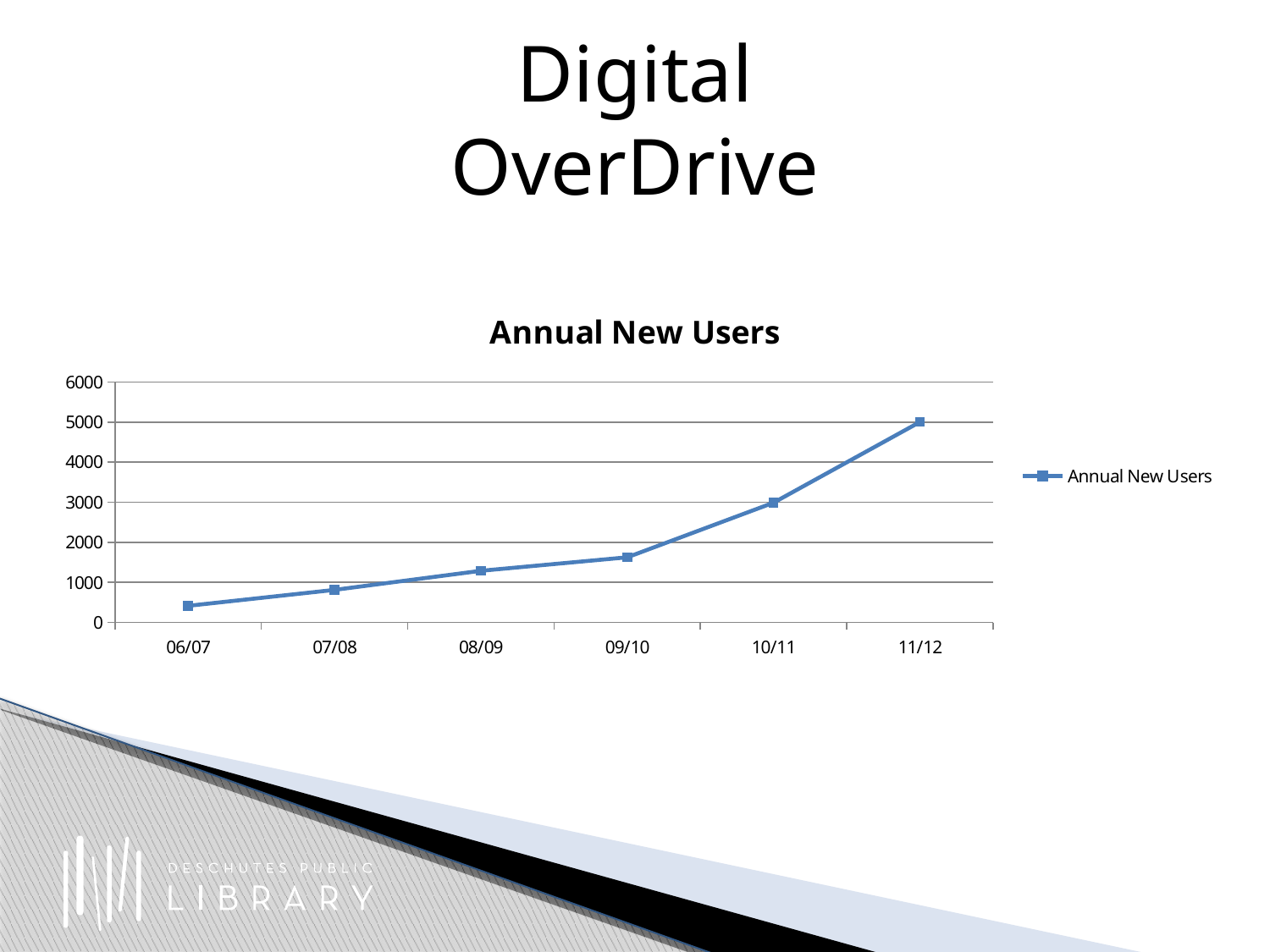
How many series does the legend list? 1 Which year has the lowest number of annual new users? 06/07 Which year has the highest number of annual new users? 11/12 What is the title of the chart? Annual New Users How many data points are plotted on the chart? 6 Is the value for 08/09 greater or less than 1000? greater Do the values rise or fall from 06/07 to 11/12? rise What kind of chart is shown on the slide? line chart Is the value for 06/07 greater or less than 1000? less Is the value for 09/10 greater or less than 2000? less Which year has more annual new users, 08/09 or 10/11? 10/11